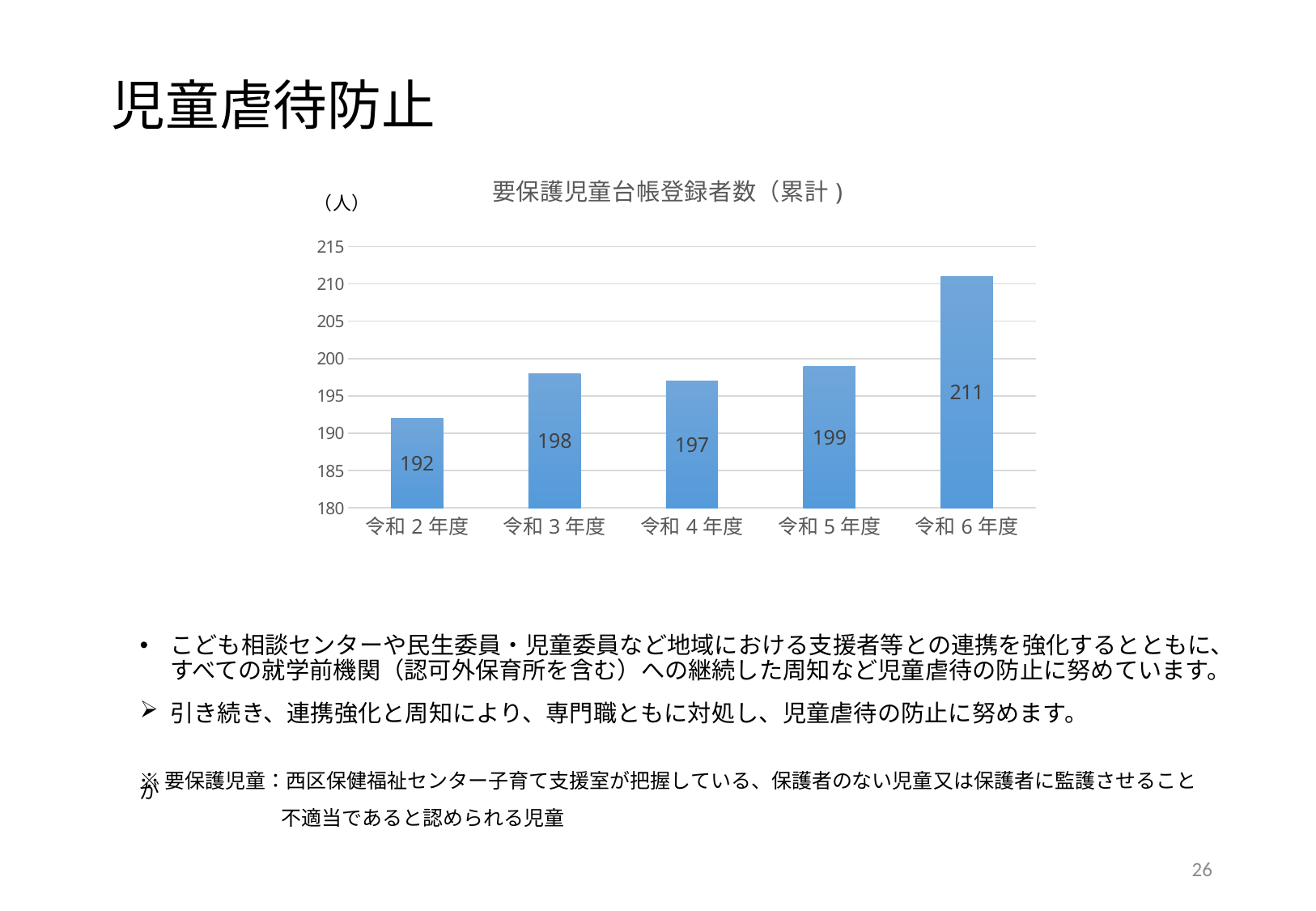
What is the value for 令和６年度? 211 What is the difference between the values for 令和６年度 and 令和５年度? 12 Is the value for 令和５年度 greater or less than 200? less What kind of chart is shown on the slide? bar chart What is the value for 令和４年度? 197 Which is larger, the value for 令和３年度 or 令和４年度? 令和３年度 Which fiscal year has the lowest value? 令和２年度 What is the difference between the values for 令和３年度 and 令和２年度? 6 Which fiscal year has the highest value? 令和６年度 What is the value for 令和２年度? 192 How many fiscal years are shown on the x axis? 5 What is the title of the chart? 要保護児童台帳登録者数（累計）